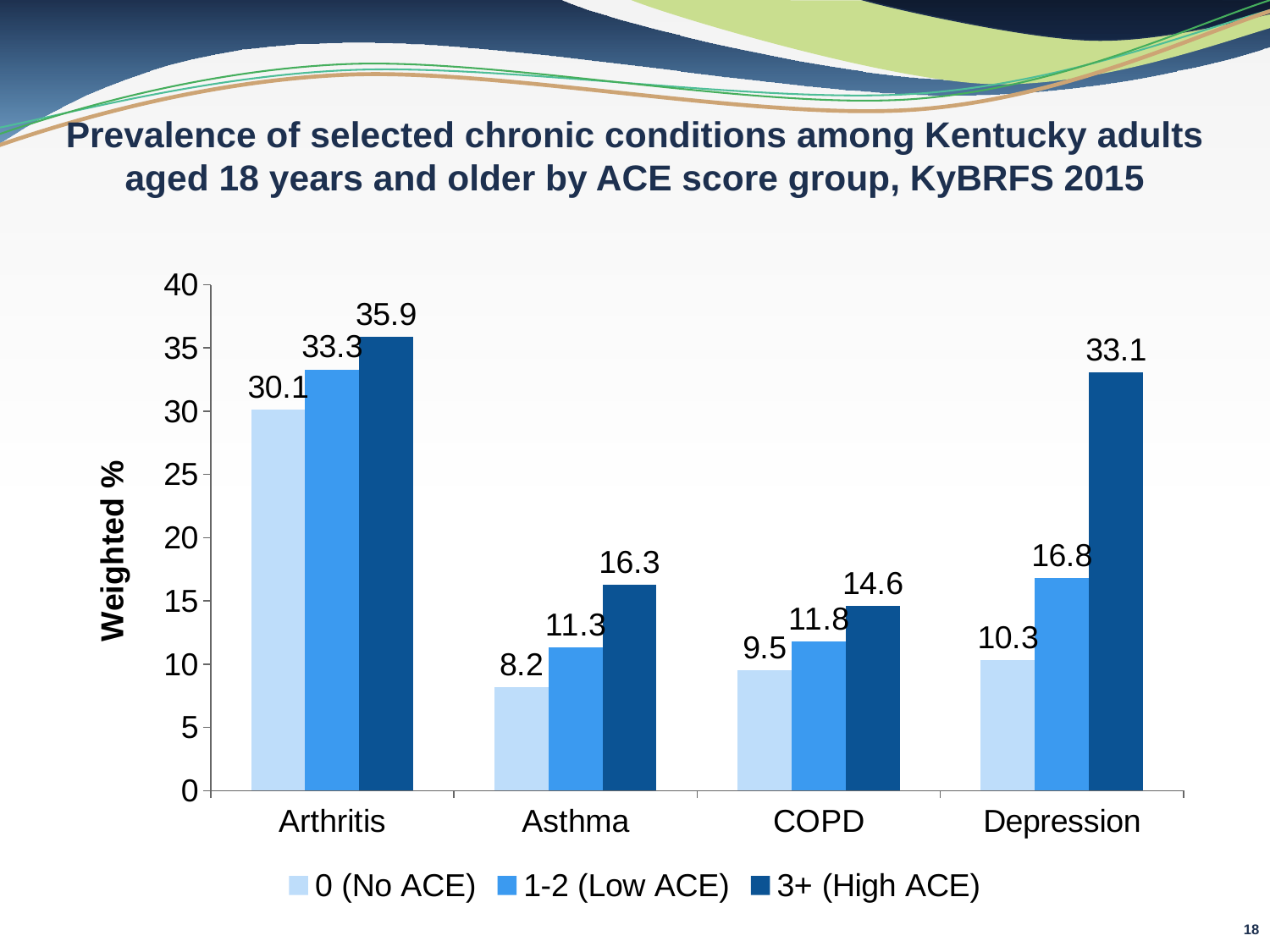
Which condition has the highest weighted % in the 0 (No ACE) group? Arthritis What is the difference between the 3+ (High ACE) and 0 (No ACE) values for Depression? 22.8 How many chronic conditions are shown on the x axis? 4 What is the weighted % for COPD in the 1-2 (Low ACE) group? 11.8 What is the weighted % for Arthritis in the 3+ (High ACE) group? 35.9 What is the weighted % for Depression in the 0 (No ACE) group? 10.3 Which is larger: the 1-2 (Low ACE) value for Asthma or the 1-2 (Low ACE) value for COPD? COPD How many series does the legend list? 3 Which condition has the lowest weighted % in the 3+ (High ACE) group? COPD Is the 3+ (High ACE) value for Asthma greater or less than 15? greater What is the label of the y axis? Weighted % What kind of chart is shown on the slide? Bar chart